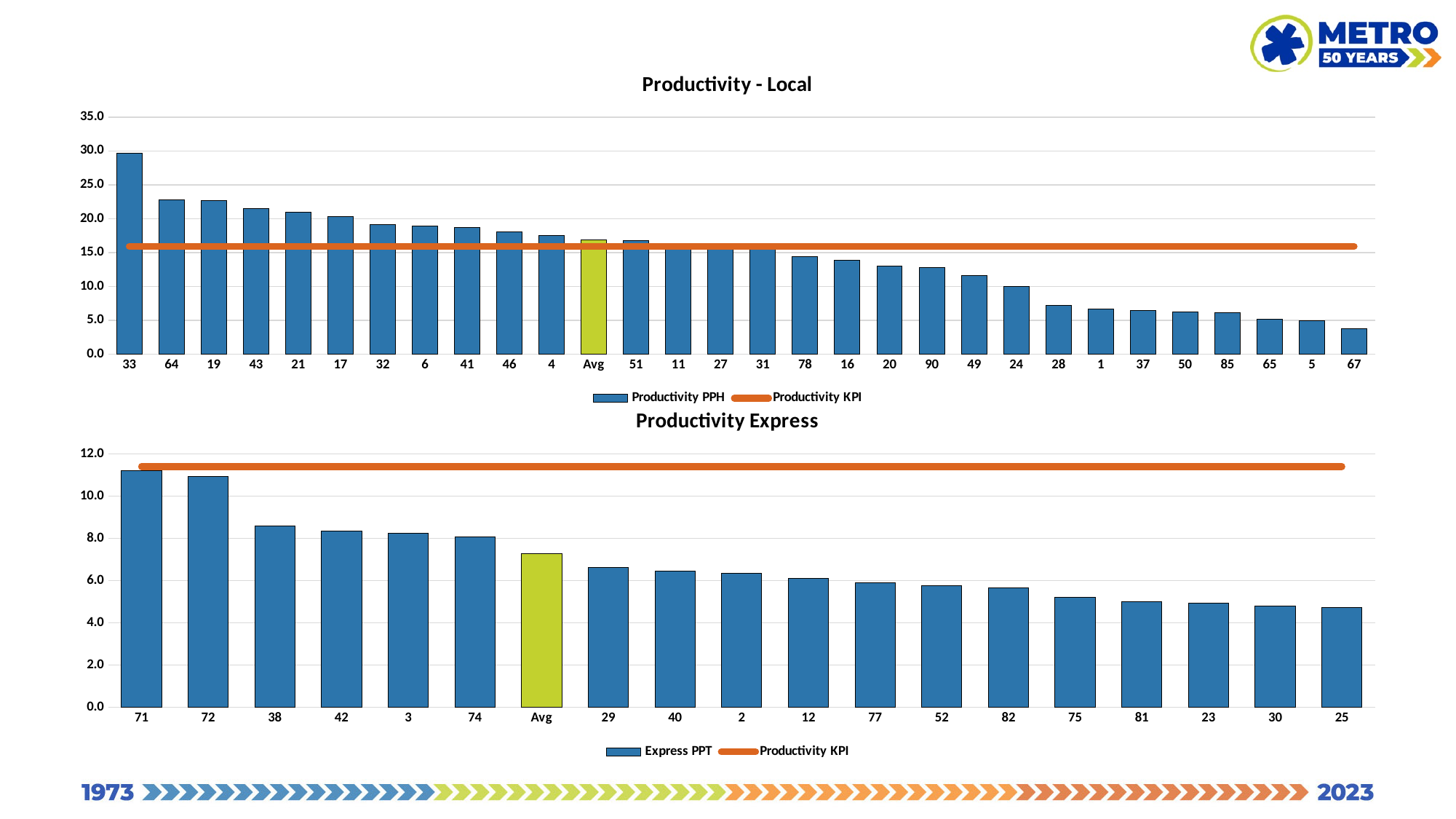
In the Productivity - Local chart, which category has the highest Productivity PPH? 33 In the Productivity Express chart, do the bar values rise or fall from left to right along the x axis? fall In the Productivity - Local chart, which category has the lowest Productivity PPH? 67 What kind of chart is the Productivity - Local chart? bar chart How many categories are shown on the x axis of the Productivity - Local chart, including Avg? 30 In the Productivity - Local chart, is the value for 67 greater or less than 5.0? less In the Productivity Express chart, which is larger, the value for 72 or the value for 38? 72 How many series does the legend of the Productivity - Local chart list? 2 In the Productivity - Local chart, is the value for 33 greater or less than 25.0? greater In the Productivity Express chart, which category has the highest Express PPT? 71 In the Productivity - Local chart, which is larger, the value for 33 or the value for 64? 33 In the Productivity Express chart, is the value for 25 greater or less than 5.0? less